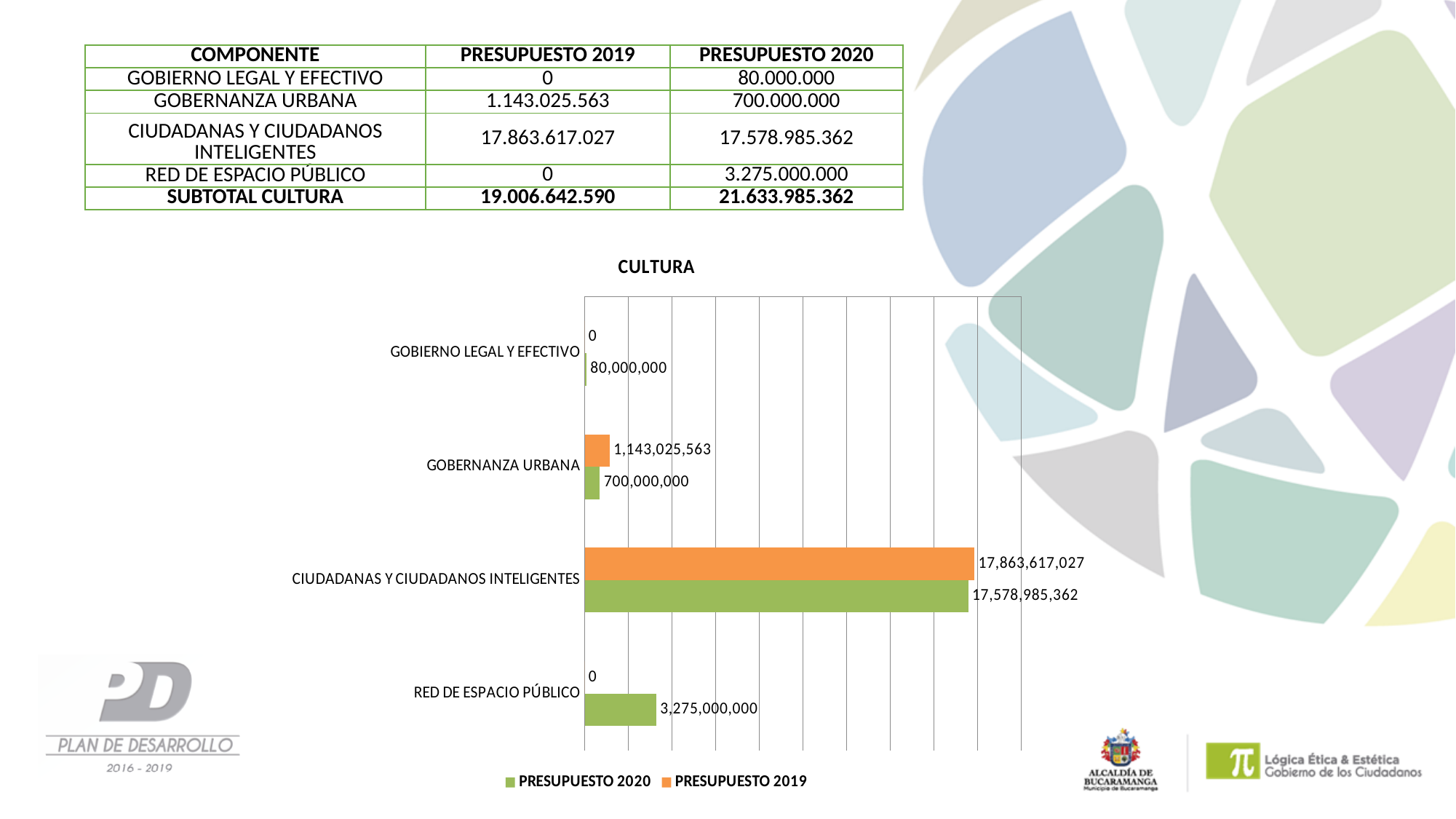
In the CULTURA chart, which component has the highest PRESUPUESTO 2020 value? CIUDADANAS Y CIUDADANOS INTELIGENTES In the CULTURA chart, what is the difference between the PRESUPUESTO 2019 and PRESUPUESTO 2020 values for GOBERNANZA URBANA? 443,025,563 How many series does the legend of the CULTURA chart list? 2 What type of chart is shown under the title CULTURA? bar chart In the CULTURA chart, what is the PRESUPUESTO 2019 value for GOBERNANZA URBANA? 1,143,025,563 In the CULTURA chart, for GOBERNANZA URBANA, which is larger: PRESUPUESTO 2019 or PRESUPUESTO 2020? PRESUPUESTO 2019 In the CULTURA chart, what is the difference between the PRESUPUESTO 2019 and PRESUPUESTO 2020 values for CIUDADANAS Y CIUDADANOS INTELIGENTES? 284,631,665 In the CULTURA chart, what is the PRESUPUESTO 2020 value for RED DE ESPACIO PÚBLICO? 3,275,000,000 In the CULTURA chart, what is the PRESUPUESTO 2019 value for CIUDADANAS Y CIUDADANOS INTELIGENTES? 17,863,617,027 How many components are shown on the CULTURA chart? 4 In the CULTURA chart, which component has the lowest PRESUPUESTO 2020 value? GOBIERNO LEGAL Y EFECTIVO In the CULTURA chart, what is the PRESUPUESTO 2020 value for GOBIERNO LEGAL Y EFECTIVO? 80,000,000